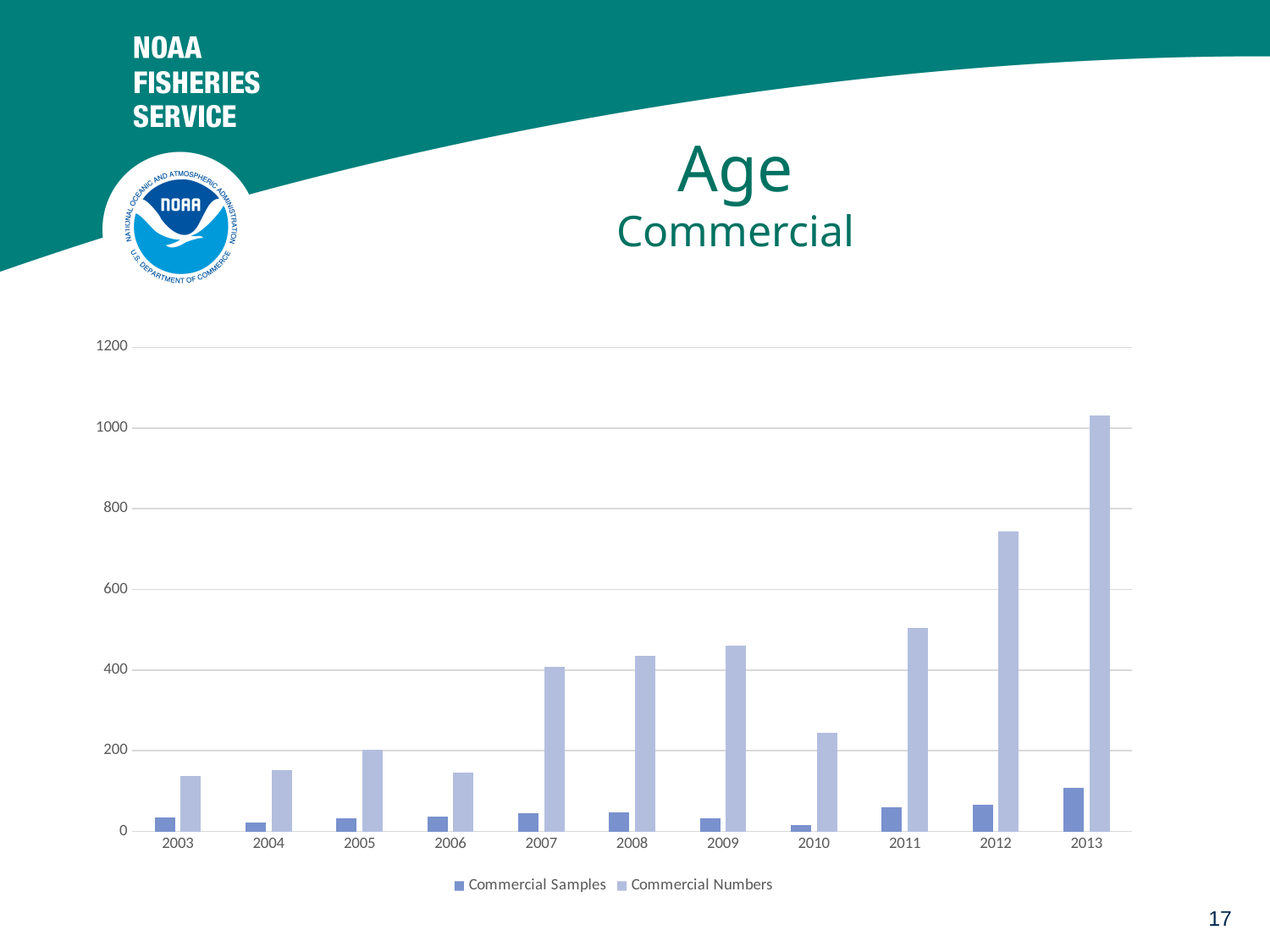
Is the Commercial Numbers value for 2010 greater or less than 200? greater How many series does the chart's legend list? 2 Which year has the highest value for Commercial Numbers? 2013 How many years are shown on the x axis of the chart? 11 Do the Commercial Numbers values rise or fall from 2010 to 2013? rise Is the Commercial Numbers value for 2012 greater or less than 800? less Which is larger, the Commercial Numbers value for 2009 or for 2010? 2009 What are the two series named in the chart's legend? Commercial Samples and Commercial Numbers What kind of chart is shown on the slide? bar chart Is the Commercial Numbers value for 2011 greater or less than 600? less Which year has the highest value for Commercial Samples? 2013